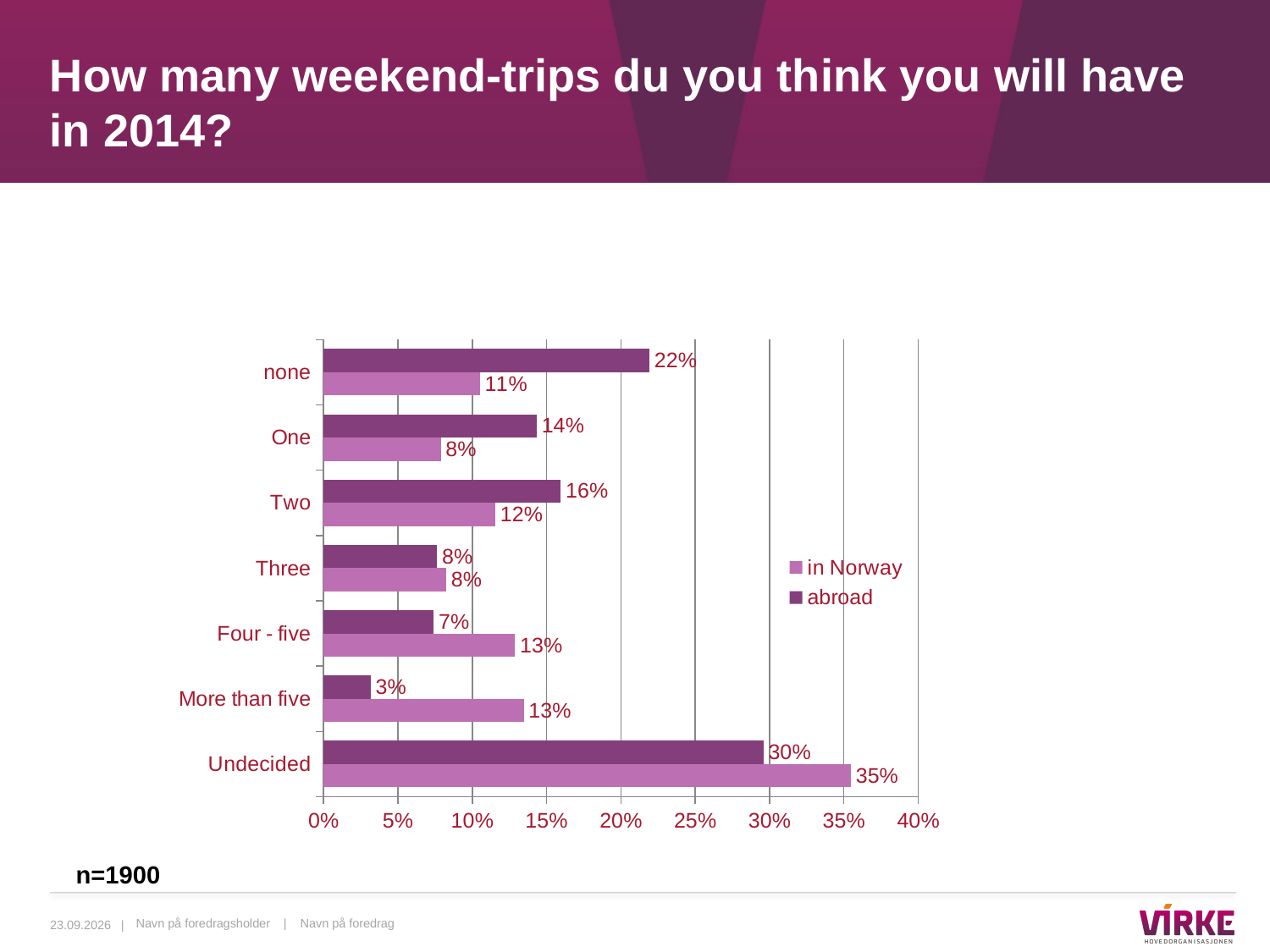
What kind of chart is shown on the slide? bar chart What is the value for 'in Norway' in the 'Undecided' category? 35% Is the 'abroad' value for 'Undecided' greater or less than 25%? greater What is the value for 'in Norway' in the 'More than five' category? 13% How many categories are shown on the chart? 7 What is the sample size stated below the chart? n=1900 For the 'Four - five' category, which series has the larger value, 'in Norway' or 'abroad'? in Norway What is the difference between the 'abroad' and 'in Norway' values for the 'none' category? 11% How many series does the legend list? 2 Which category has the lowest value for the 'abroad' series? More than five Which category has the highest value for the 'abroad' series? Undecided What is the value for 'abroad' in the 'none' category? 22%